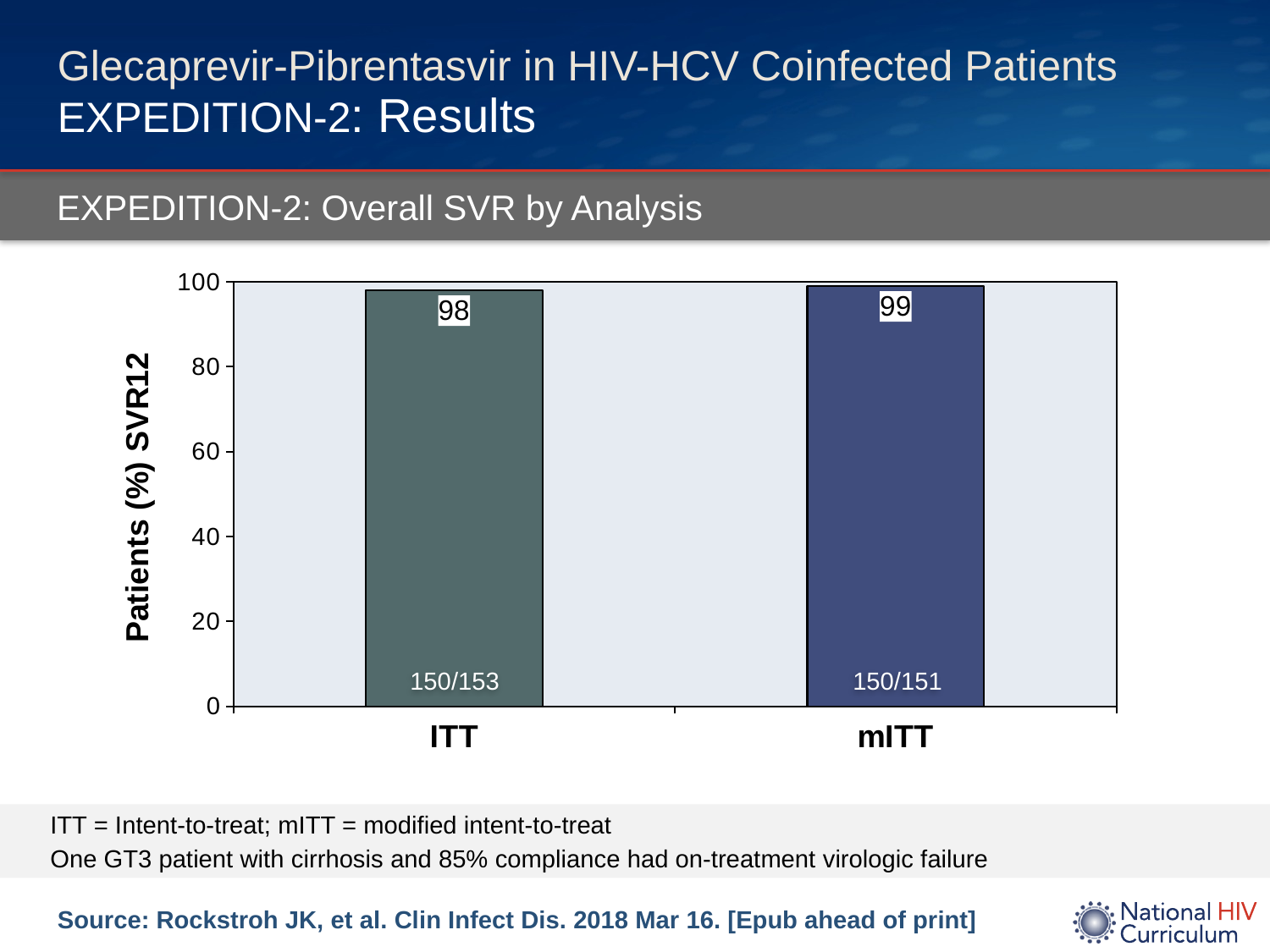
Is the SVR12 value for ITT greater or less than 80? greater What is the SVR12 percentage for the ITT analysis? 98 Which analysis has the lower SVR12 percentage? ITT Which analysis has the higher SVR12 percentage? mITT What is the label of the y axis? Patients (%) SVR12 What fraction of patients is shown inside the ITT bar? 150/153 What is the difference in SVR12 percentage between mITT and ITT? 1 What kind of chart is shown on the slide? Bar chart What is the title of the chart? EXPEDITION-2: Overall SVR by Analysis What is the SVR12 percentage for the mITT analysis? 99 How many analysis categories are shown on the x axis? 2 What fraction of patients is shown inside the mITT bar? 150/151